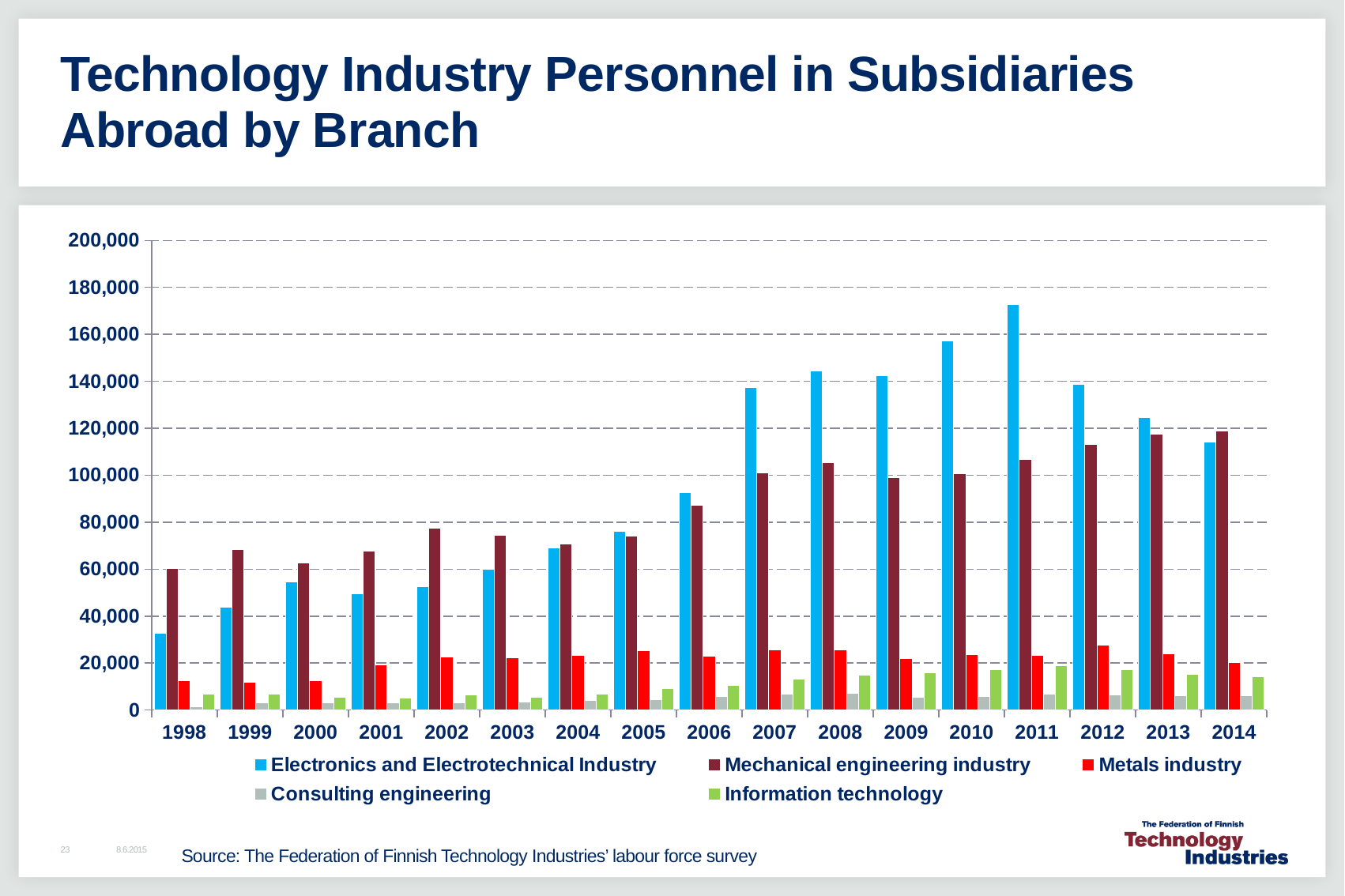
What kind of chart is shown on the slide? Bar chart Do the Electronics and Electrotechnical Industry values rise or fall from 2011 to 2014? Fall Is the value for Mechanical engineering industry in 2014 greater or less than 100,000? greater In 1998, which is larger: Electronics and Electrotechnical Industry or Mechanical engineering industry? Mechanical engineering industry Is the value for Electronics and Electrotechnical Industry in 1998 greater or less than 40,000? less Is the value for Electronics and Electrotechnical Industry in 2011 greater or less than 160,000? greater In which year is the Electronics and Electrotechnical Industry value lowest? 1998 How many series does the legend list? 5 In which year is the Electronics and Electrotechnical Industry value highest? 2011 How many years are shown on the x axis? 17 What colour represents the Metals industry series? Red